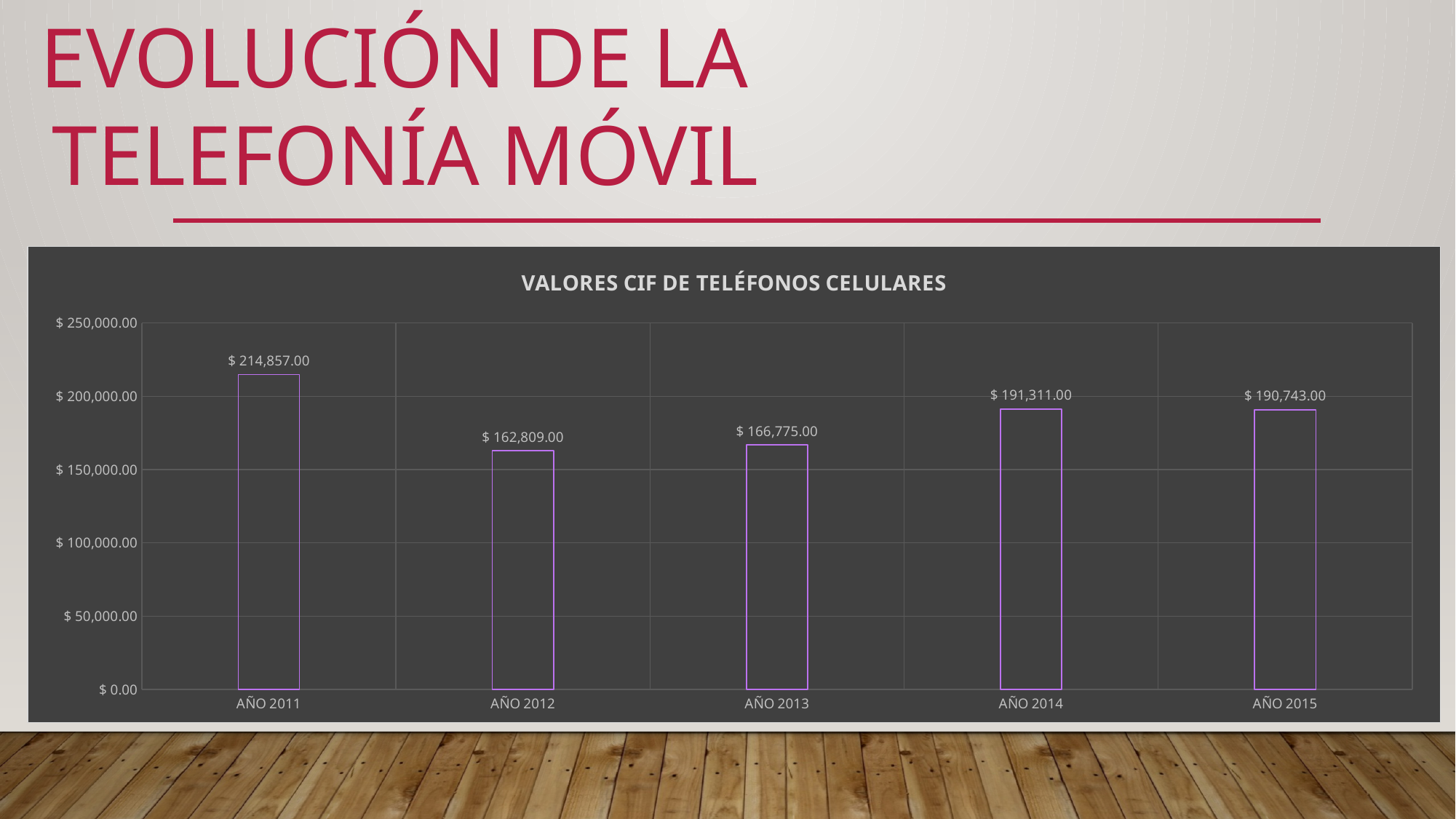
What kind of chart is shown on the slide? bar chart What is the difference between the values for AÑO 2014 and AÑO 2015? $ 568.00 Which year has the highest value? AÑO 2011 What is the difference between the values for AÑO 2011 and AÑO 2012? $ 52,048.00 Is the value for AÑO 2012 greater or less than $ 200,000.00? less Which year has the lowest value? AÑO 2012 How many years are shown on the x axis? 5 Which is larger, the value for AÑO 2011 or the value for AÑO 2014? AÑO 2011 What is the title of the chart? VALORES CIF DE TELÉFONOS CELULARES What is the value for AÑO 2013? $ 166,775.00 What is the value for AÑO 2015? $ 190,743.00 What is the value for AÑO 2011? $ 214,857.00